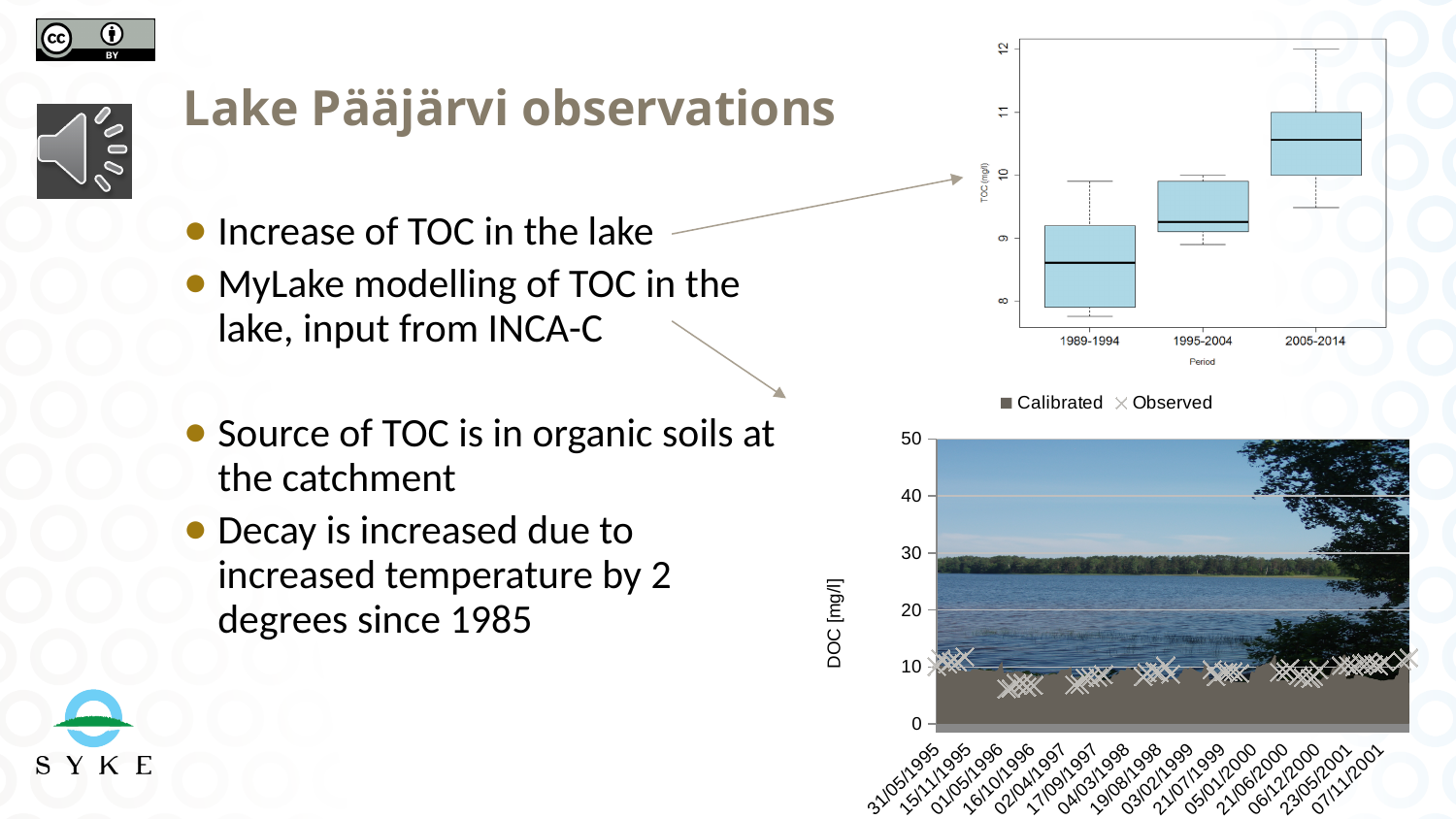
In the box plot at the top right, does the median TOC rise or fall from 1989-1994 to 2005-2014? rise In the DOC chart at the bottom right, how many series does the legend list? 2 In the box plot at the top right, is the median TOC for 1989-1994 greater or less than 9? less In the DOC chart at the bottom right, are the observed values greater or less than 20 mg/l? less In the box plot at the top right, how many periods are shown on the x axis? 3 In the box plot at the top right, is the median TOC for 2005-2014 greater or less than 10? greater In the box plot at the top right, which period has the lowest median TOC? 1989-1994 In the DOC chart at the bottom right, how many date labels are shown on the x axis? 15 In the box plot at the top right, which period has the larger median TOC, 1995-2004 or 2005-2014? 2005-2014 In the box plot at the top right, what is the label of the x axis? Period In the DOC chart at the bottom right, what are the two legend entries? Calibrated and Observed In the box plot at the top right, which period has the highest median TOC? 2005-2014